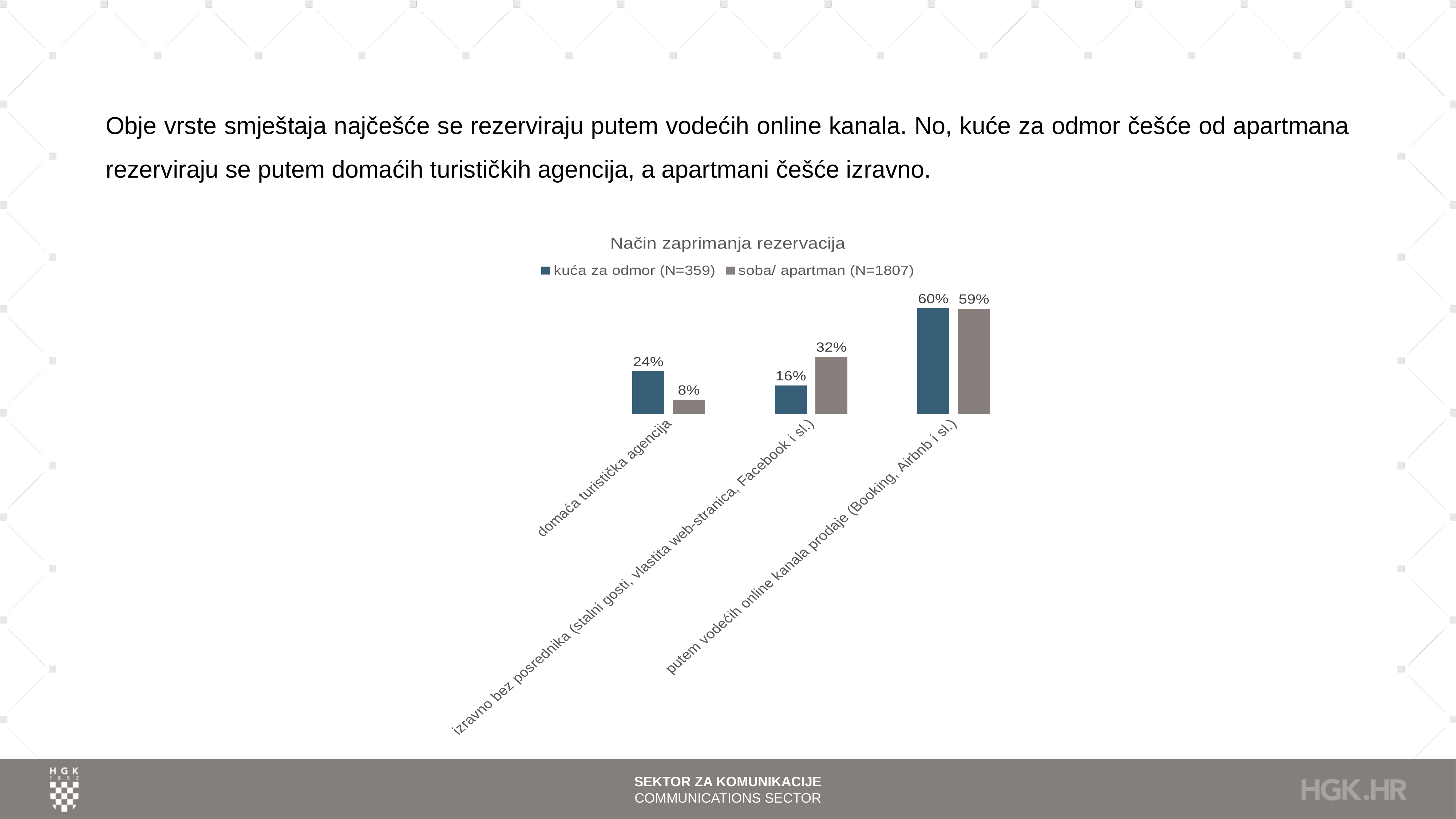
Which category has the lowest value for 'soba/ apartman (N=1807)'? domaća turistička agencija How many series does the legend list? 2 What is the difference between 'soba/ apartman (N=1807)' and 'kuća za odmor (N=359)' in the 'izravno bez posrednika' category? 16% What is the value for 'kuća za odmor (N=359)' in the 'izravno bez posrednika' category? 16% What is the title of the chart? Način zaprimanja rezervacija What is the value for 'soba/ apartman (N=1807)' in the 'domaća turistička agencija' category? 8% What is the value for 'soba/ apartman (N=1807)' in the 'putem vodećih online kanala prodaje' category? 59% How many categories are shown on the x axis? 3 What kind of chart is shown on the slide? bar chart What is the value for 'kuća za odmor (N=359)' in the 'domaća turistička agencija' category? 24% Which category has the highest value for 'kuća za odmor (N=359)'? putem vodećih online kanala prodaje (Booking, Airbnb i sl.) Which series has the larger value in the 'domaća turistička agencija' category? kuća za odmor (N=359)